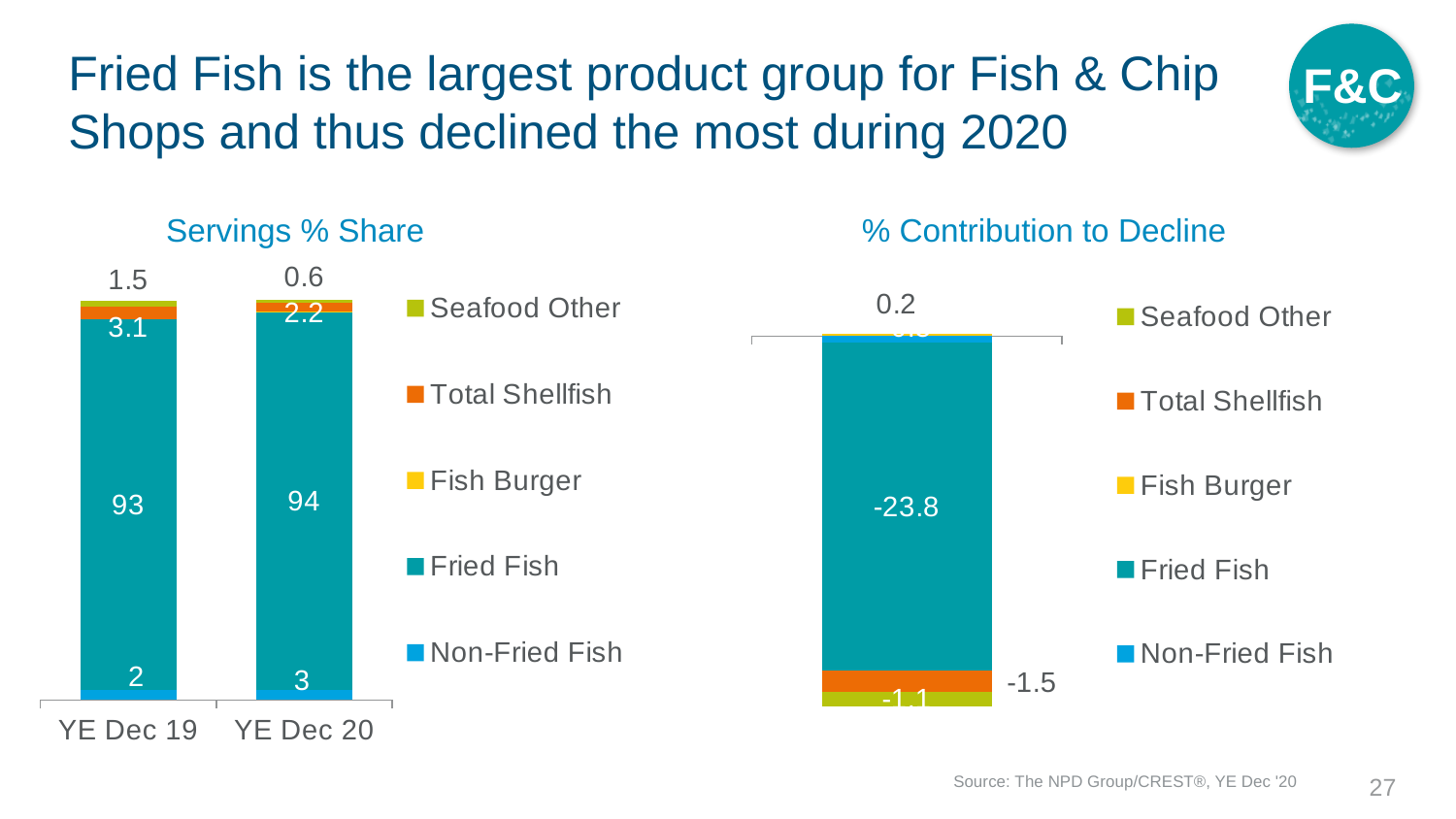
In the 'Servings % Share' chart, what is the value for Fried Fish in YE Dec 19? 93 In the '% Contribution to Decline' chart, what is the value for Fried Fish? -23.8 In the 'Servings % Share' chart, which period has the larger Non-Fried Fish value, YE Dec 19 or YE Dec 20? YE Dec 20 How many categories (time periods) are shown on the x axis of the 'Servings % Share' chart? 2 What kind of chart is the 'Servings % Share' chart on the left? Stacked bar chart In the 'Servings % Share' chart, what is the value for Non-Fried Fish in YE Dec 20? 3 In the 'Servings % Share' chart, by how much did the Fried Fish value change from YE Dec 19 to YE Dec 20? 1 In the 'Servings % Share' chart, which series has the largest share in YE Dec 20? Fried Fish In the '% Contribution to Decline' chart, which series contributes the most to the decline? Fried Fish In the 'Servings % Share' chart, what is the value for Non-Fried Fish in YE Dec 19? 2 How many series does the legend of the 'Servings % Share' chart list? 5 In the 'Servings % Share' chart, what is the value for Fried Fish in YE Dec 20? 94